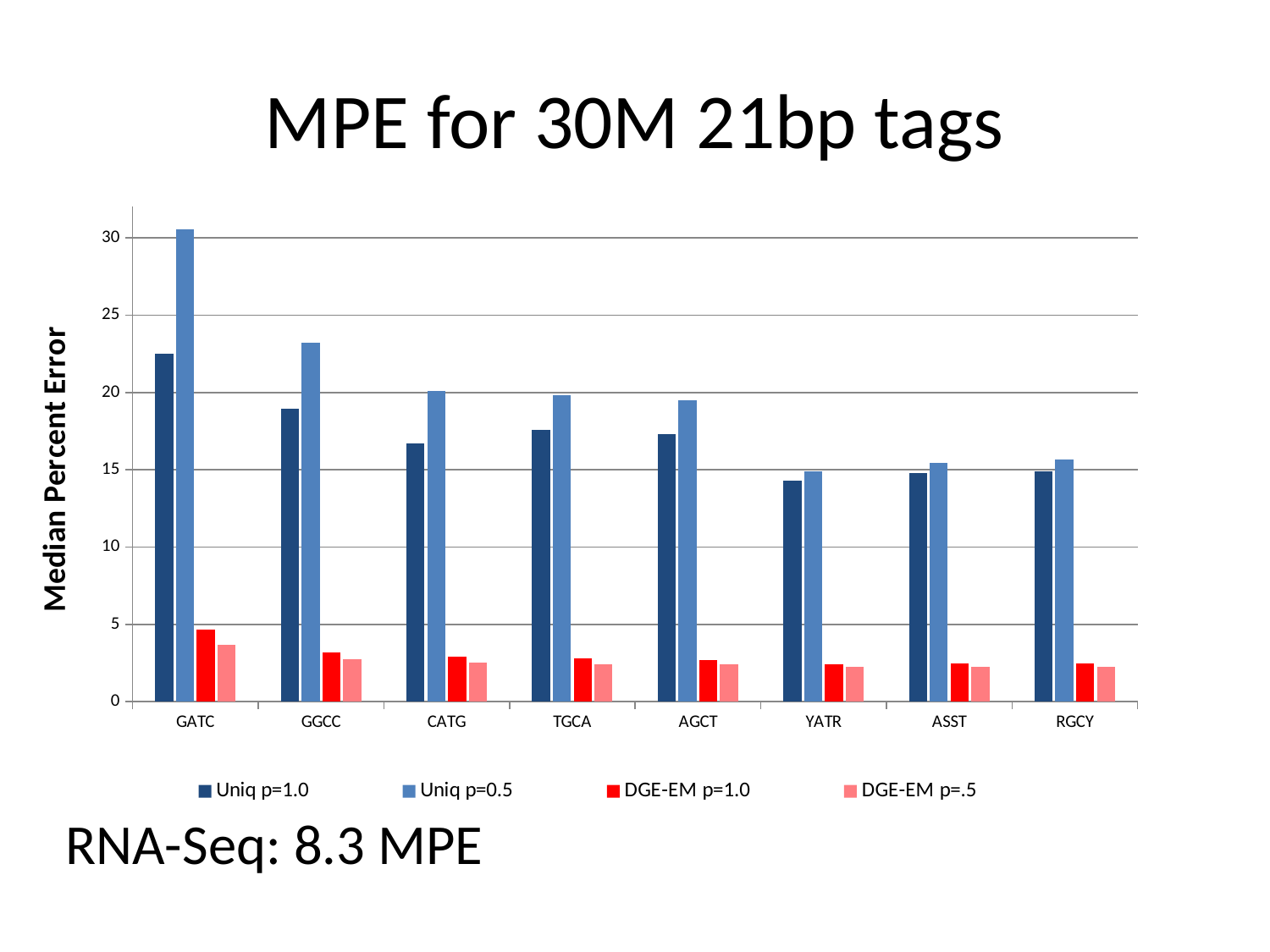
Is the Uniq p=1.0 value for YATR greater or less than 15? less Is the Uniq p=1.0 value for GATC greater or less than 20? greater How many series does the legend list? 4 What kind of chart is shown on the slide? bar chart Which is larger, the Uniq p=0.5 value for GATC or the Uniq p=0.5 value for GGCC? GATC Is the Uniq p=0.5 value for GATC greater or less than 25? greater How many categories are shown on the x axis? 8 Which category has the highest value for the DGE-EM p=1.0 series? GATC Which category has the highest value for the Uniq p=0.5 series? GATC What is the title of the y axis? Median Percent Error For CATG, which series has the larger value, Uniq p=1.0 or DGE-EM p=1.0? Uniq p=1.0